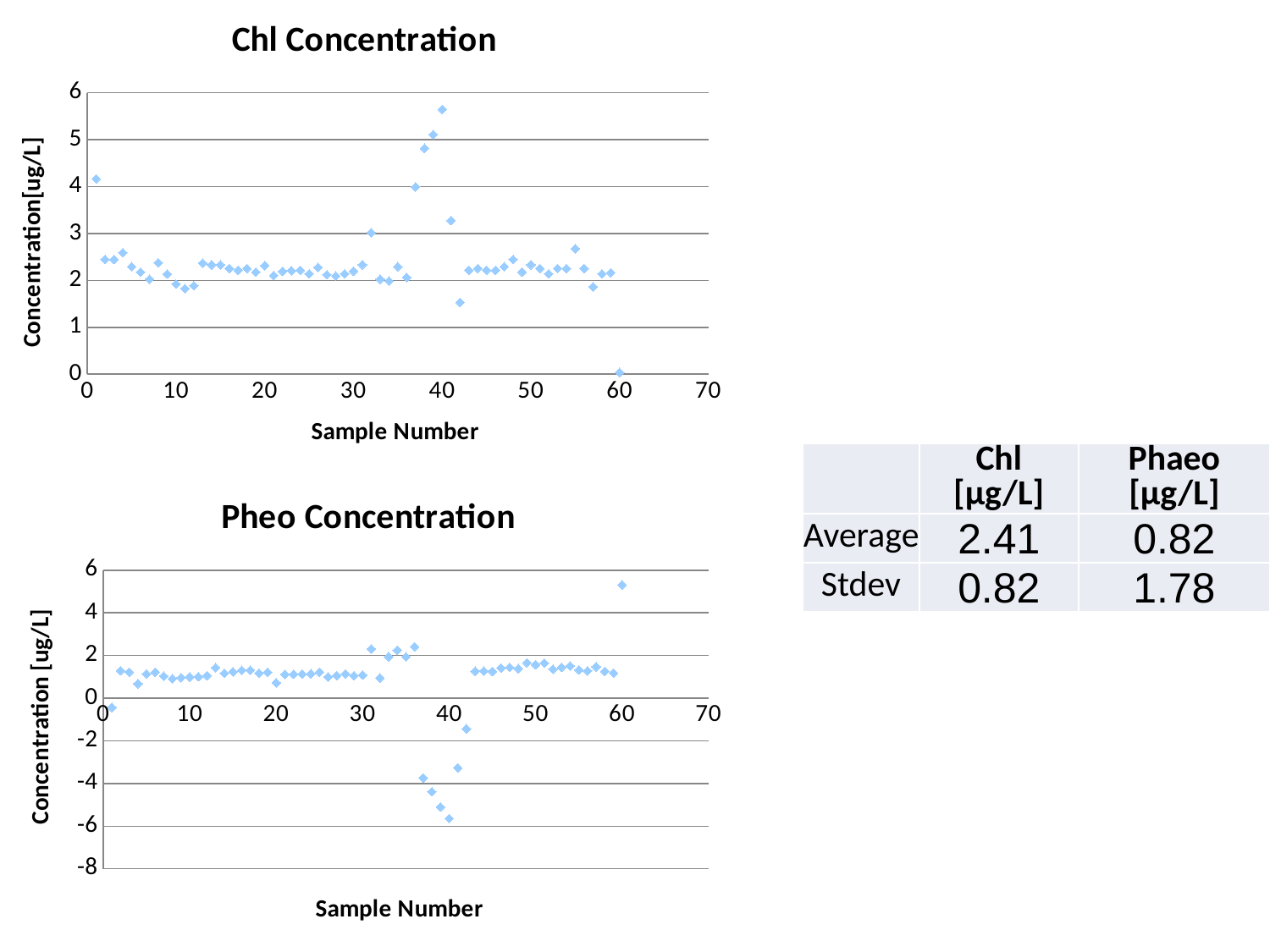
In the Pheo Concentration chart, is the value for sample 60 greater or less than 4? greater In the Chl Concentration chart, is the value for sample 40 greater or less than 5? greater In the Pheo Concentration chart, is the value for sample 40 greater or less than -4? less What is the x-axis label of the Chl Concentration chart? Sample Number In the Pheo Concentration chart, which is larger, the value for sample 60 or the value for sample 40? sample 60 What kind of chart is the Chl Concentration chart? scatter chart What kind of chart is the Pheo Concentration chart? scatter chart What is the lowest value shown on the y-axis of the Pheo Concentration chart? -8 In the Chl Concentration chart, which is larger, the value for sample 40 or the value for sample 60? sample 40